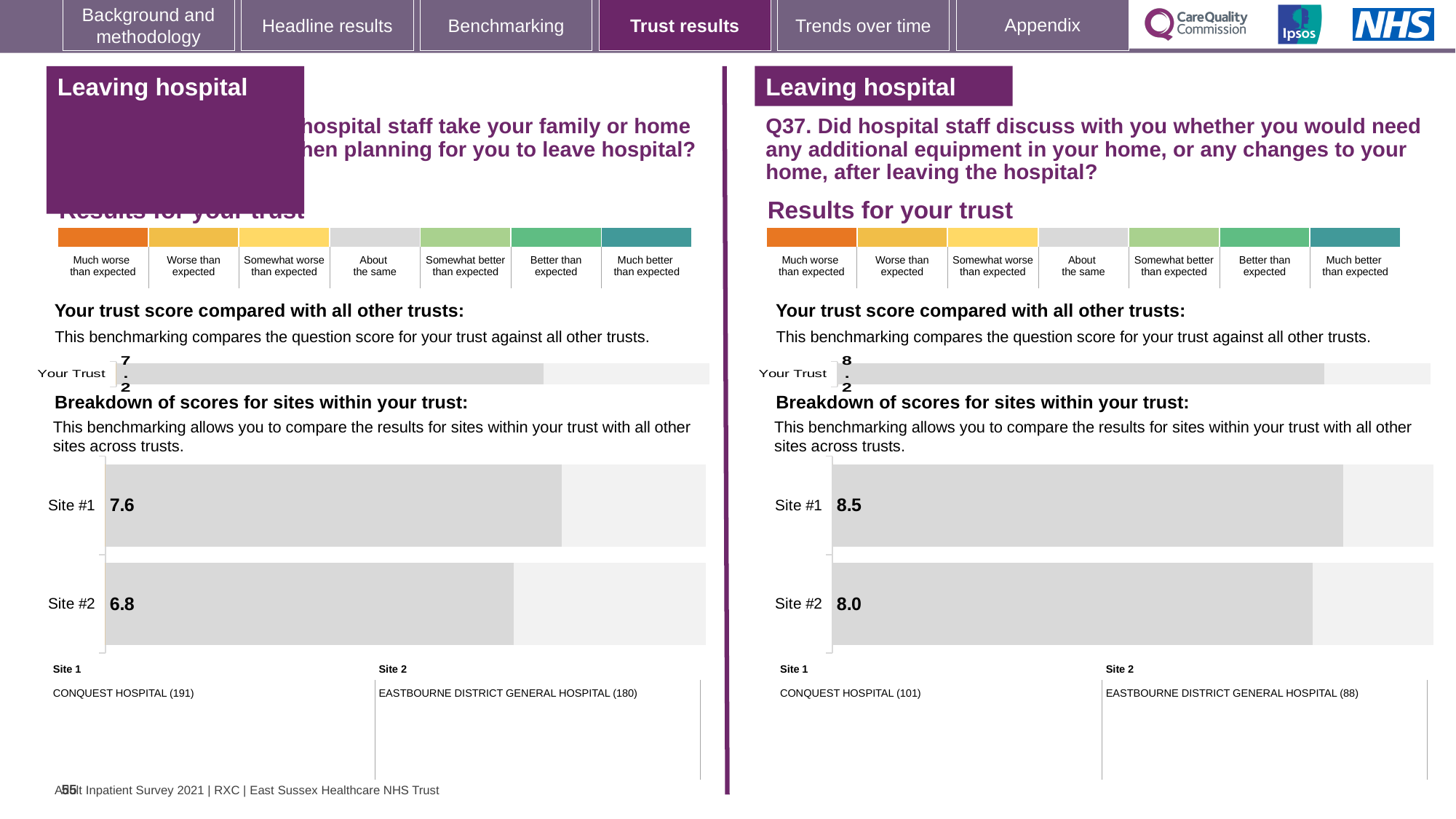
On the left-hand site breakdown chart, what is the difference between the Site #1 and Site #2 scores? 0.8 On the right-hand chart (Q37), what is the score for Site #1? 8.5 On the left-hand chart, what is the score for Site #1? 7.6 On the right-hand site breakdown chart (Q37), what is the difference between the Site #1 and Site #2 scores? 0.5 On the right-hand site breakdown chart (Q37), which site has the lower score? Site #2 On the right-hand chart (Q37), what is the score shown for Your Trust? 8.2 On the right-hand chart (Q37), what is the score for Site #2? 8.0 On the left-hand chart, what is the score shown for Your Trust? 7.2 How many sites are shown in the right-hand site breakdown chart (Q37)? 2 On the left-hand site breakdown chart, which site has the higher score? Site #1 What type of chart is used for the site breakdown on the left-hand side? Bar chart On the left-hand chart, what is the score for Site #2? 6.8